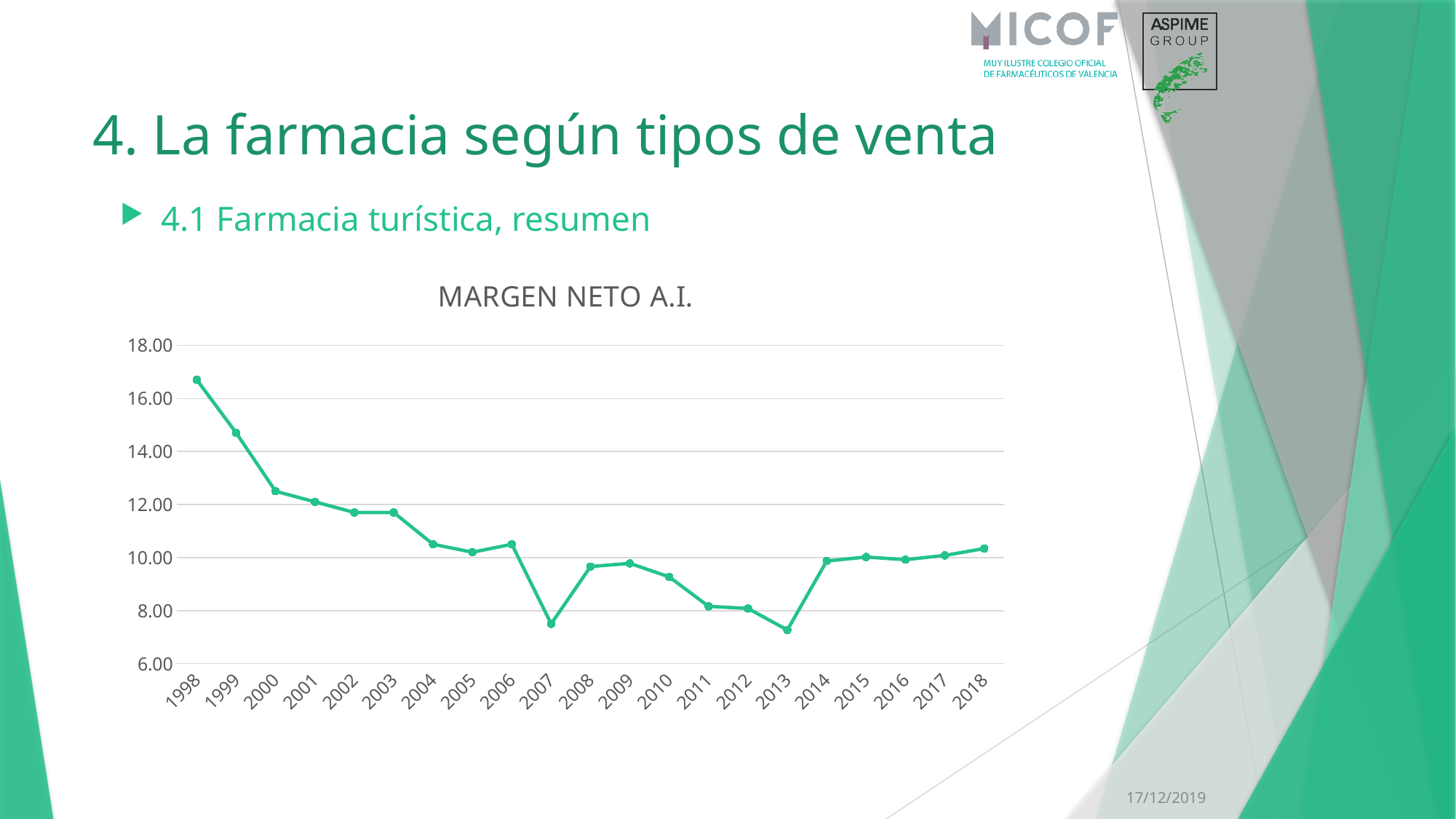
Is the value for 2000 greater or less than 12.00? greater What type of chart is shown on the slide? Line chart Does the value generally rise or fall from 1998 to 2007? fall Is the value for 2007 greater or less than 8.00? less Is the value for 1998 greater or less than 16.00? greater Which year has the larger value, 2013 or 2014? 2014 Which year has the larger value, 1998 or 2018? 1998 Which year has the lowest value in the chart? 2013 Which year has the highest value in the chart? 1998 What is the title of the chart? MARGEN NETO A.I. How many years are plotted on the x axis of the chart? 21